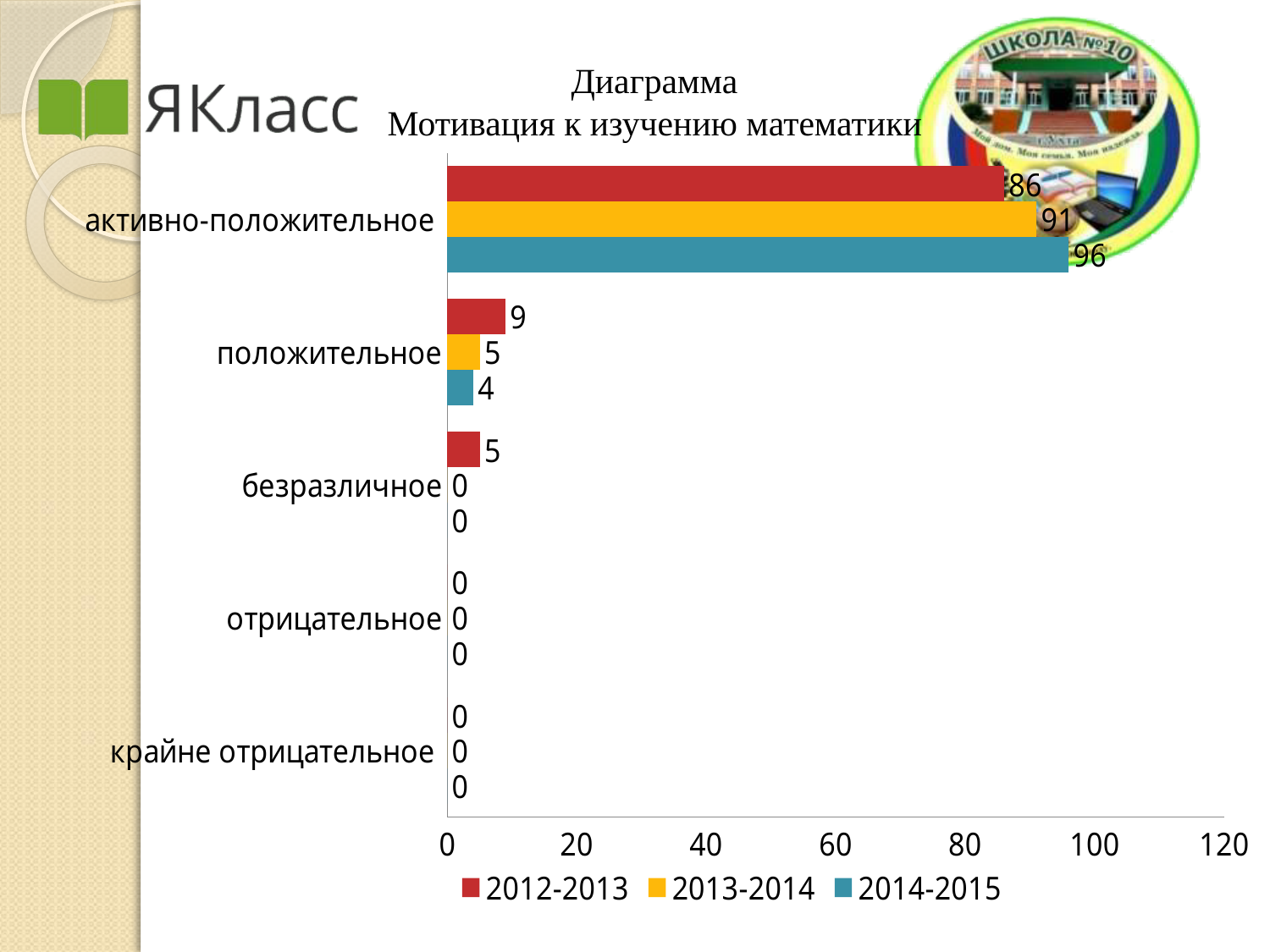
Which colour represents the 2014-2015 series in the legend? blue What is the difference between the 2014-2015 and 2012-2013 values for активно-положительное? 10 What is the value for активно-положительное in the 2013-2014 series? 91 How many series does the legend list? 3 What is the value for безразличное in the 2012-2013 series? 5 How many categories are shown on the chart? 5 What is the value for отрицательное in the 2013-2014 series? 0 What is the value for положительное in the 2012-2013 series? 9 What kind of chart is shown on the slide? bar chart Which category has the highest value in the 2014-2015 series? активно-положительное What is the value for активно-положительное in the 2014-2015 series? 96 Which is larger for положительное: the 2013-2014 value or the 2014-2015 value? 2013-2014